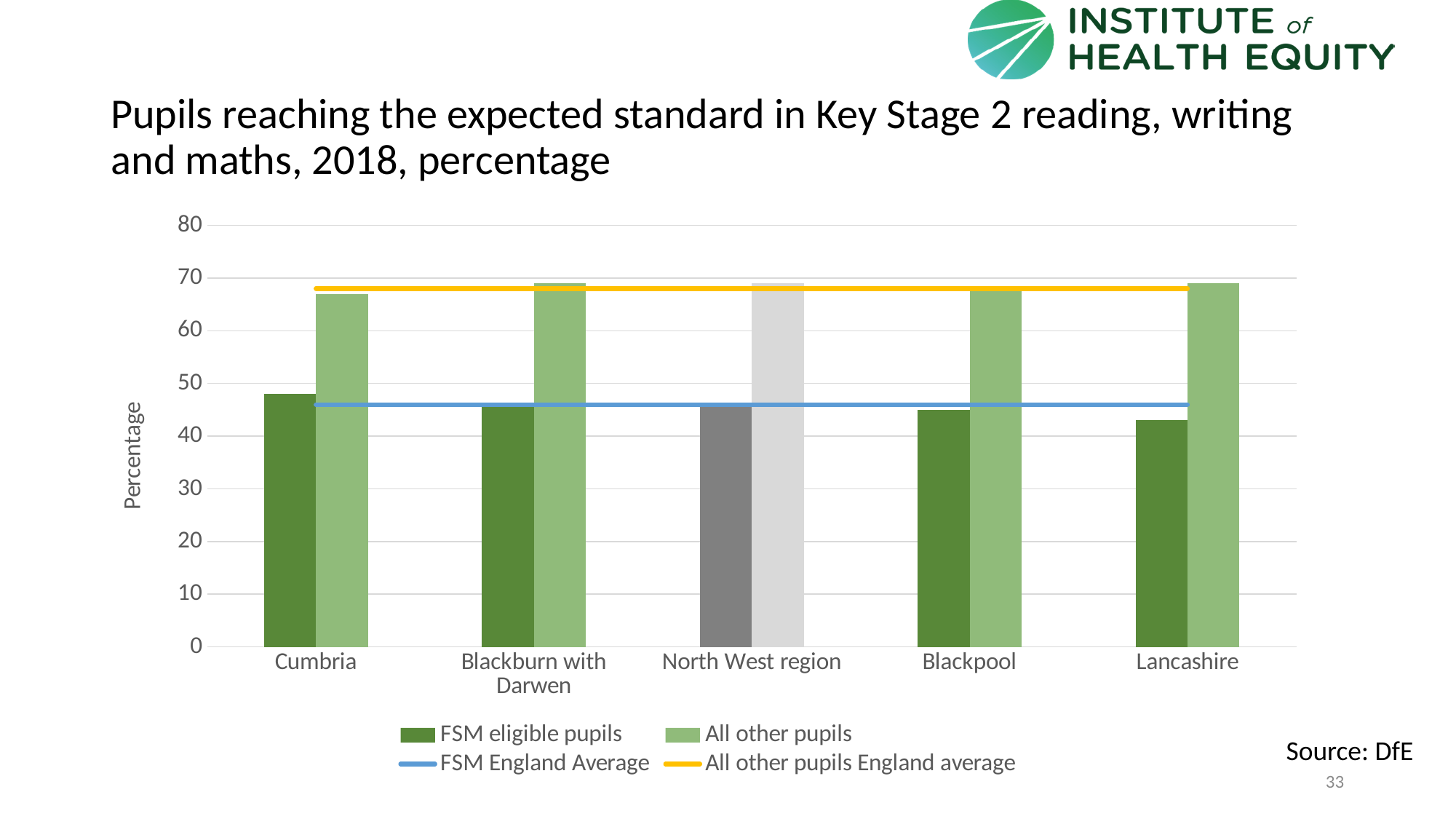
What is the label on the vertical axis? Percentage Is the value for All other pupils in Lancashire greater or less than 60? greater What kind of chart is shown on the slide? bar chart What source is cited for the chart data? DfE Which area has the lowest value for FSM eligible pupils? Lancashire How many series does the legend list? 4 Is the value for FSM eligible pupils in Cumbria greater or less than 40? greater How many areas (categories) are shown on the x axis? 5 Which is larger: the FSM eligible pupils value for Cumbria or for Lancashire? Cumbria Which area has the highest value for FSM eligible pupils? Cumbria In Blackpool, which is larger: the value for FSM eligible pupils or for All other pupils? All other pupils Is the value for FSM eligible pupils in Lancashire greater or less than 50? less